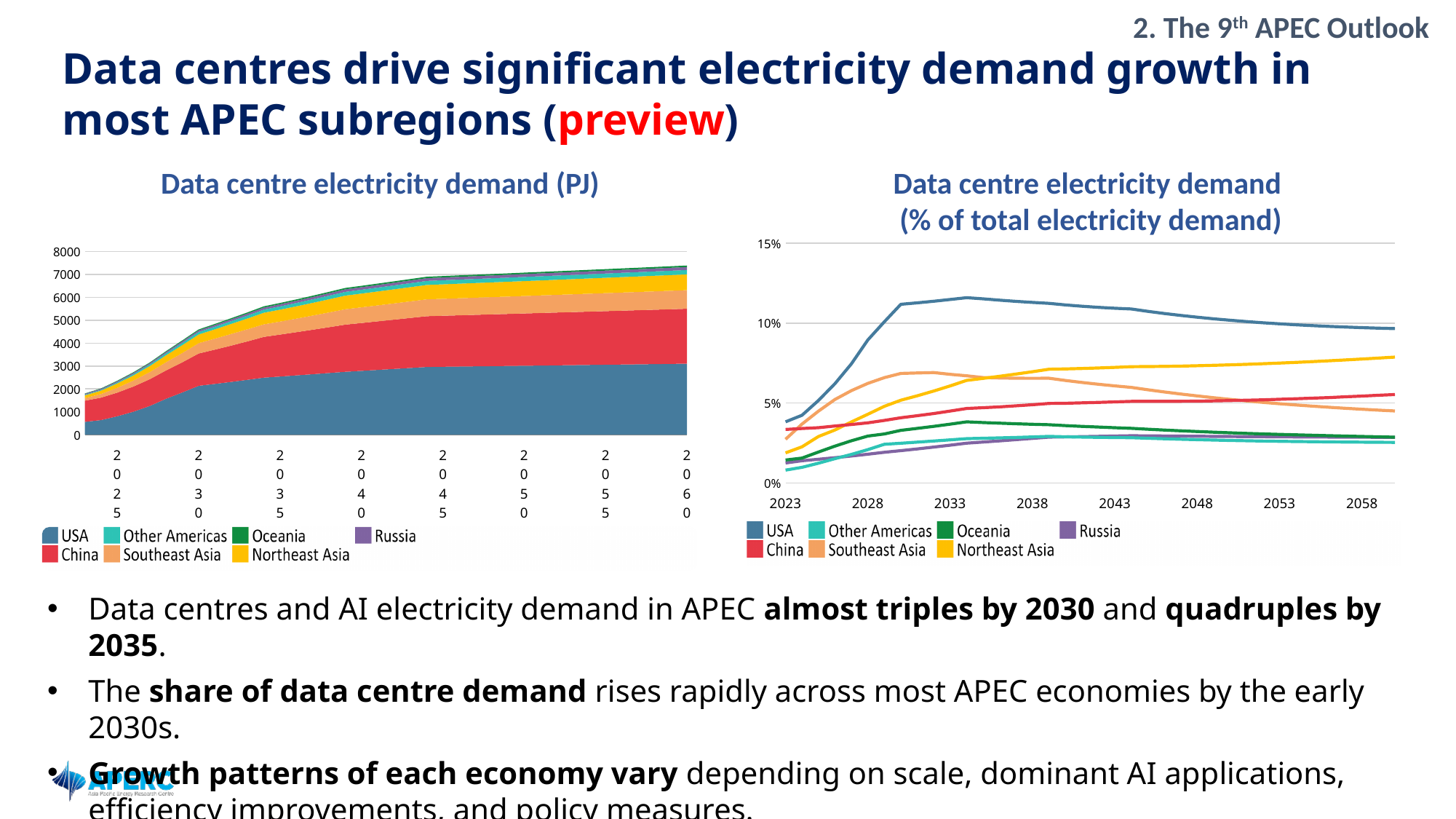
How many year labels are shown on the x axis of the left chart? 8 What kind of chart is the left chart, 'Data centre electricity demand (PJ)'? Stacked area chart How many series does the legend of the right chart list? 7 In the left chart, which series forms the largest band of the stacked area? USA In the right chart, is the USA value in 2033 greater or less than 10%? greater In the right chart, which is larger in 2058: Northeast Asia or Southeast Asia? Northeast Asia In the right chart, does the Northeast Asia line rise or fall from 2023 to 2058? Rises In the right chart, does the USA line rise or fall between 2038 and 2058? Falls In the right chart, is the USA value in 2023 greater or less than 5%? less In the right chart, which series has the highest share in 2033? USA In the left chart, is the total data centre electricity demand in 2025 greater or less than 3000 PJ? less What kind of chart is the right chart, 'Data centre electricity demand (% of total electricity demand)'? Line chart